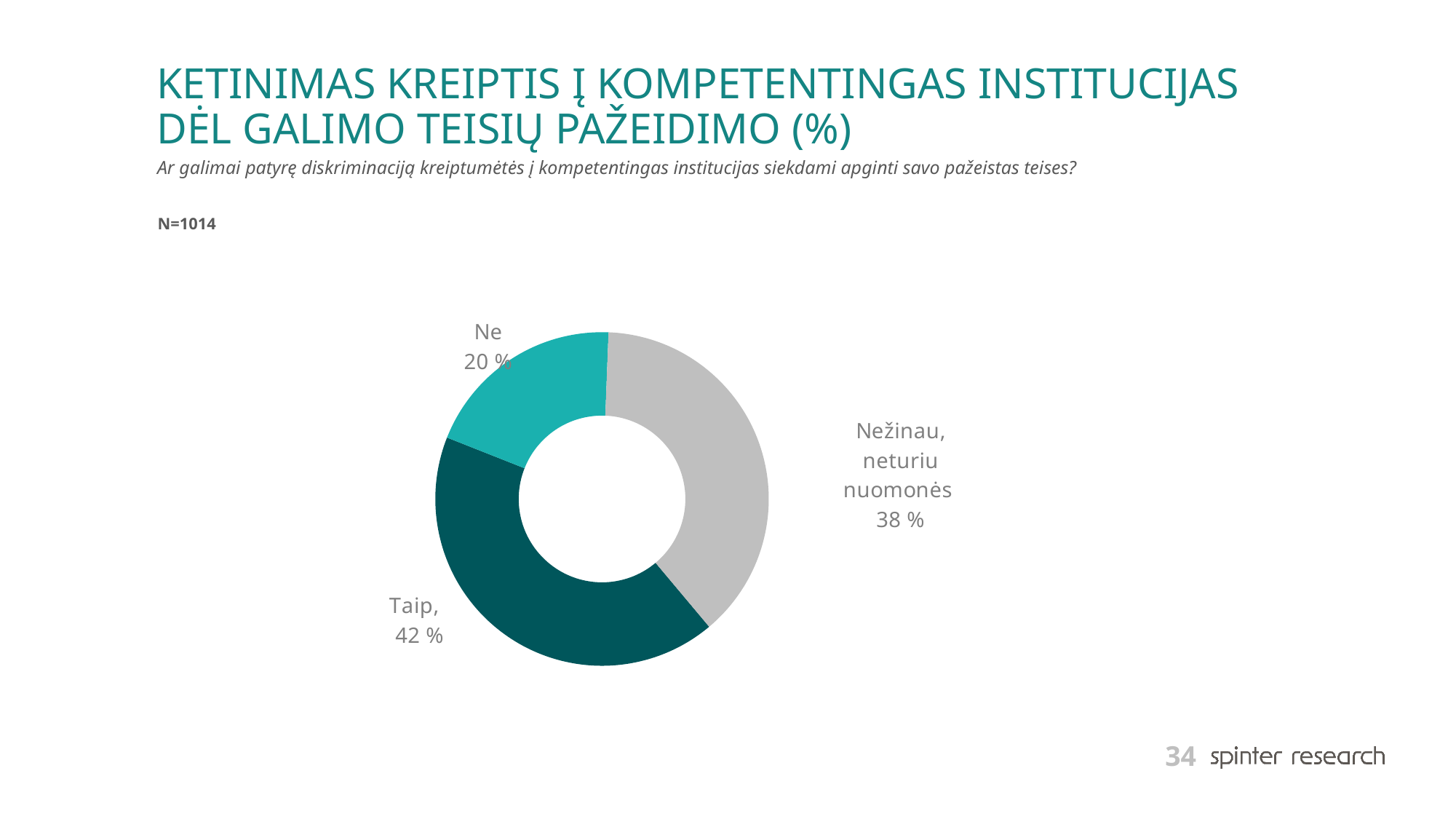
How many categories are shown in the chart? 3 What colour is the "Taip" segment of the chart? Dark teal Which response has the smallest share of the chart? Ne What kind of chart is shown on the slide? Doughnut (pie) chart What percentage of respondents answered "Taip"? 42 % What percentage of respondents answered "Ne"? 20 % What percentage of respondents answered "Nežinau, neturiu nuomonės"? 38 % What is the difference in percentage points between "Taip" and "Ne"? 22 What is the sample size (N) stated on the slide? N=1014 Which is larger, the share for "Ne" or the share for "Nežinau, neturiu nuomonės"? Nežinau, neturiu nuomonės What is the difference in percentage points between "Taip" and "Nežinau, neturiu nuomonės"? 4 Which response has the largest share of the chart? Taip